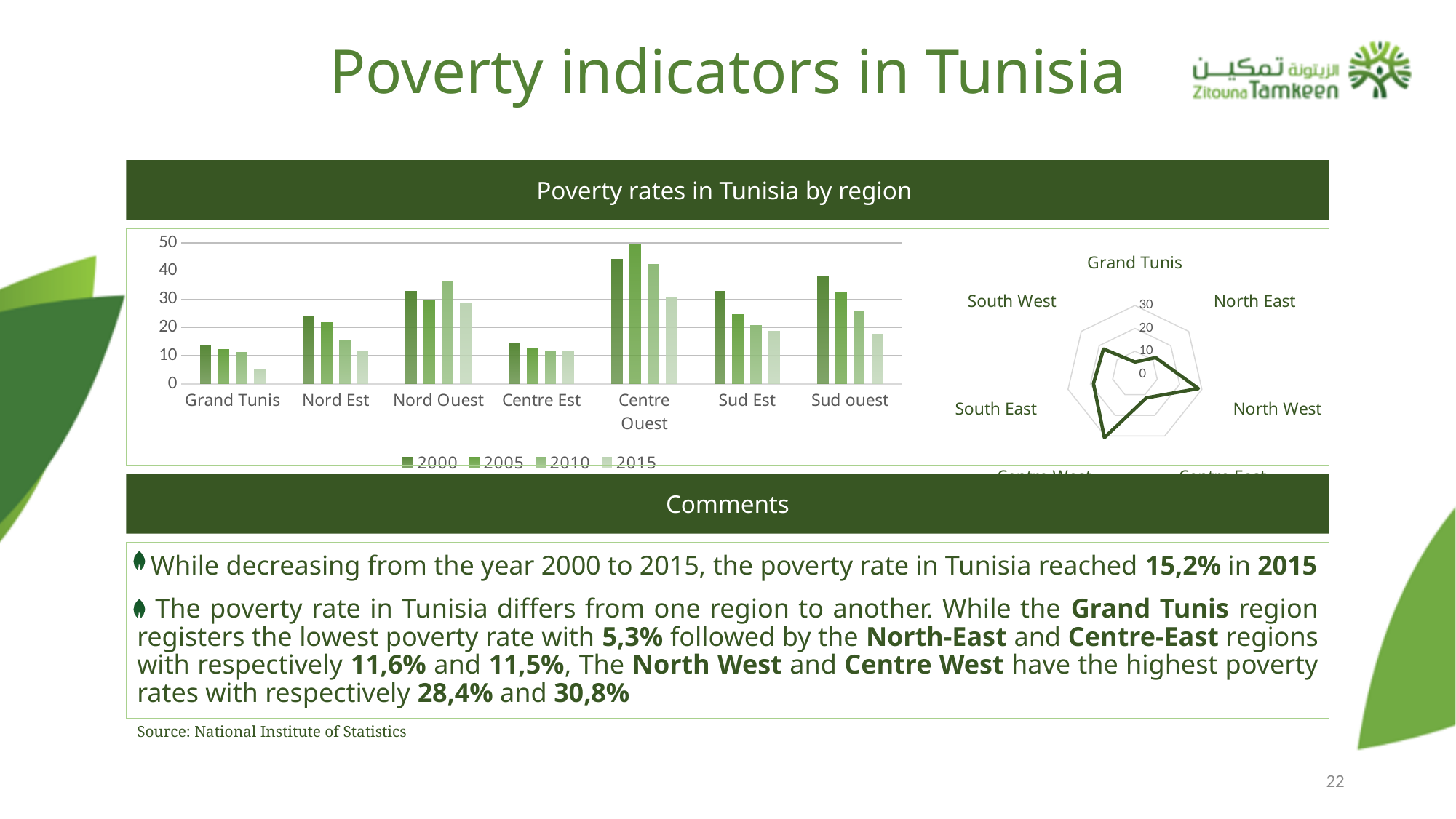
How many series does the legend of the bar chart list? 4 In the bar chart, is the 2015 value for Grand Tunis greater or less than 10? less In the bar chart, which is larger: the 2000 value for Nord Ouest or the 2000 value for Centre Est? Nord Ouest In the bar chart, is the 2000 value for Sud ouest greater or less than 30? greater What kind of chart is the left chart under 'Poverty rates in Tunisia by region'? bar chart How many regions are shown on the x axis of the bar chart? 7 In the radar chart on the right, is the value for North West greater or less than 20? greater What years are listed in the legend of the bar chart? 2000, 2005, 2010, 2015 In the bar chart, which region has the lowest poverty rate for 2015? Grand Tunis In the bar chart, do the values for Sud Est rise or fall from 2000 to 2015? fall In the bar chart, which region has the highest poverty rate for 2000? Centre Ouest